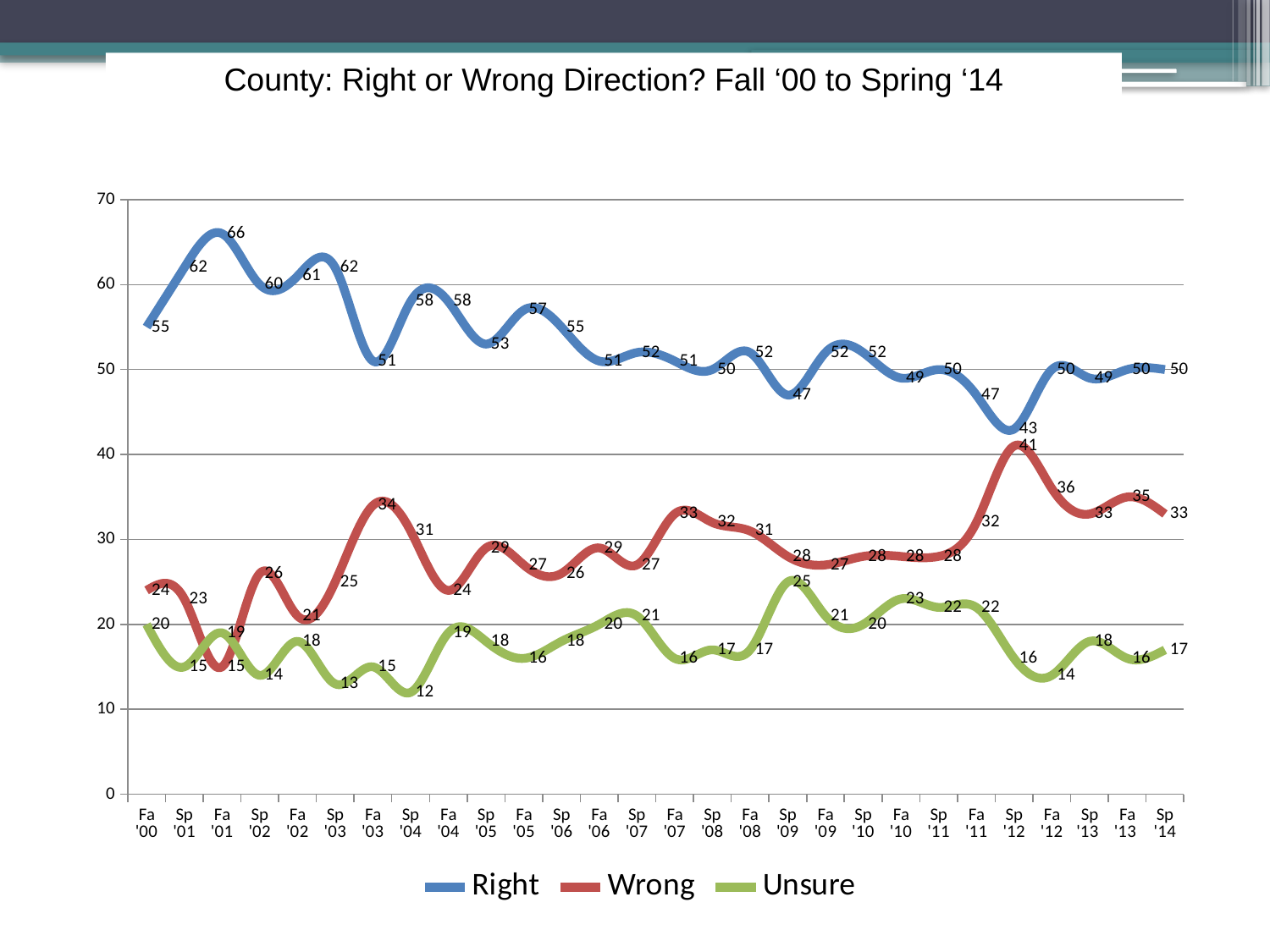
At which survey period does the Unsure series reach its lowest value? Sp '04 At which survey period does the Wrong series reach its highest value? Sp '12 What type of chart is shown on the slide? line chart Which is larger at Fa '03: the Right value or the Wrong value? Right What is the value of the Wrong series at Sp '12? 41 What is the value of the Unsure series at Sp '09? 25 What is the difference between the Right and Wrong values at Sp '14? 17 How many series does the legend list? 3 At which survey period does the Right series reach its lowest value? Sp '12 What is the title of the chart? County: Right or Wrong Direction? Fall '00 to Spring '14 How many survey periods are shown on the x axis? 28 What is the value of the Right series at Fa '01? 66